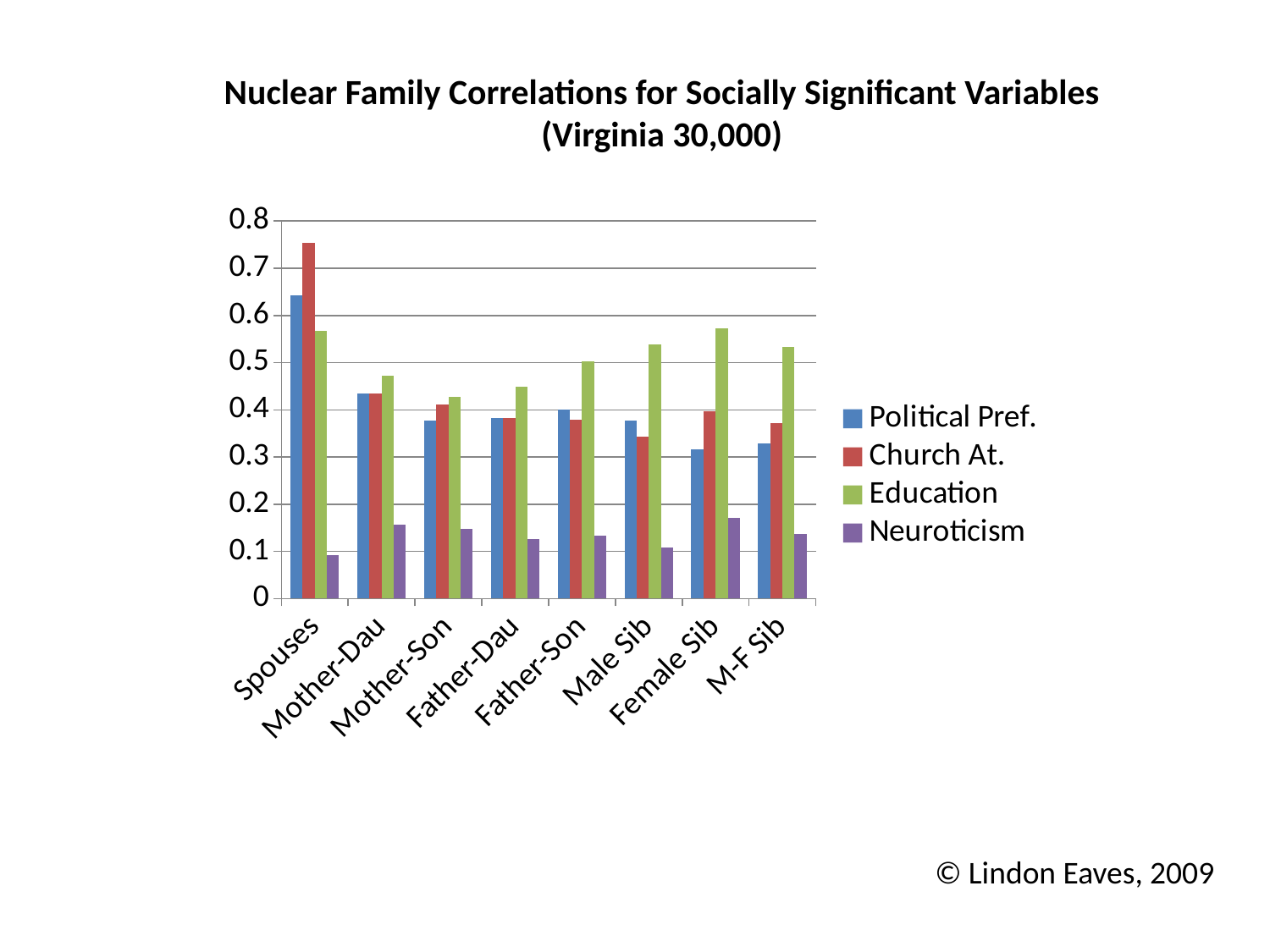
How many family relationship categories are shown on the x axis? 8 Is the Education value for Female Sib greater or less than 0.5? greater For Spouses, which is larger: the Church At. value or the Political Pref. value? Church At. For which category is the Church At. correlation highest? Spouses Is the Political Pref. value for Female Sib greater or less than 0.4? less For which category is the Political Pref. correlation highest? Spouses For Male Sib, which is larger: the Education value or the Political Pref. value? Education How many series does the legend list? 4 Is the Church At. value for Spouses greater or less than 0.7? greater What kind of chart is shown on the slide? bar chart What colour represents the Education series in the legend? green